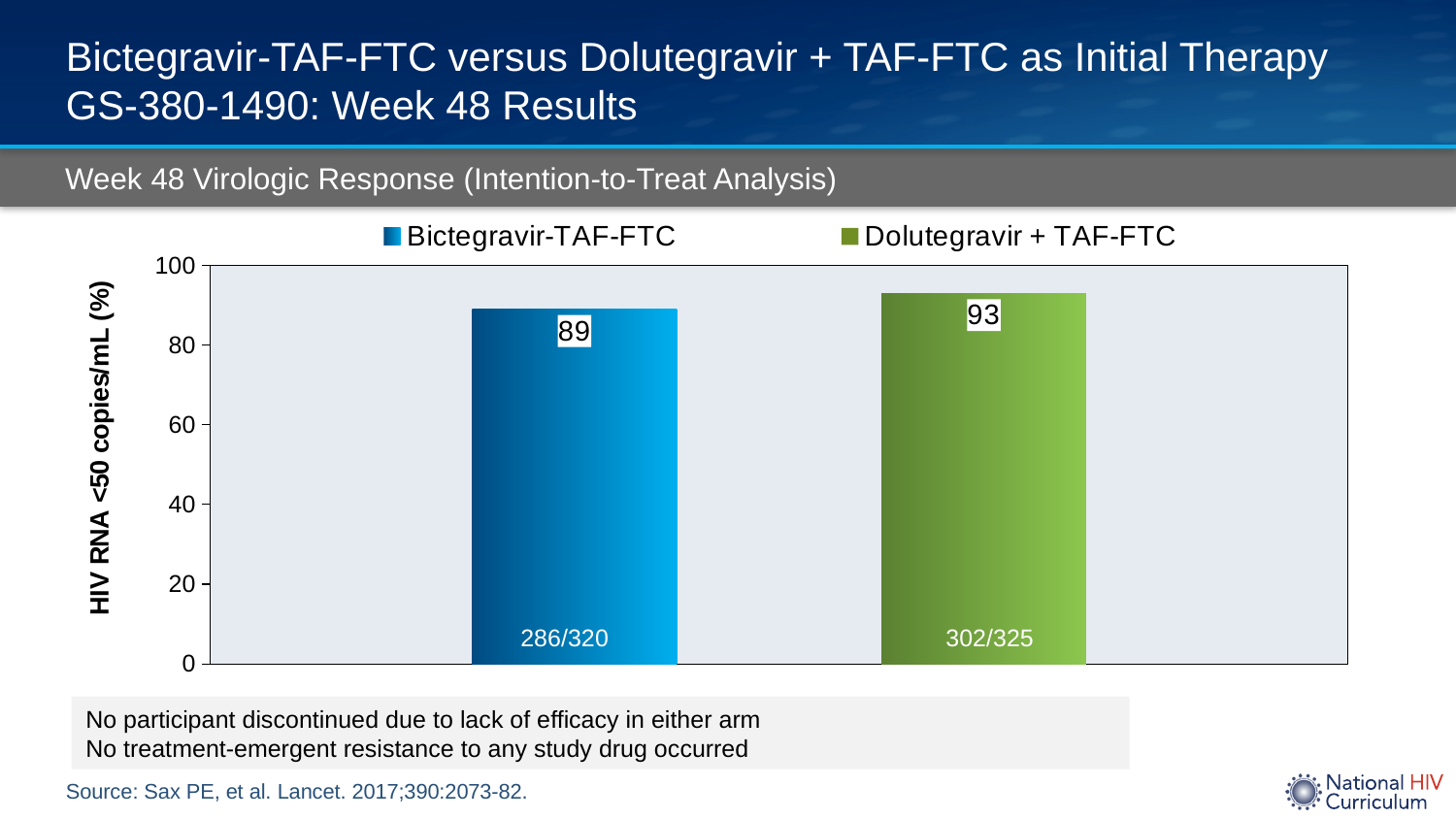
What is the value for Dolutegravir + TAF-FTC? 93 Is the value for Bictegravir-TAF-FTC greater or less than 80? greater What is the value for Bictegravir-TAF-FTC? 89 Is the value for Bictegravir-TAF-FTC larger or smaller than the value for Dolutegravir + TAF-FTC? smaller What kind of chart is shown? bar chart Which treatment arm has the higher value? Dolutegravir + TAF-FTC What fraction is printed at the base of the Bictegravir-TAF-FTC bar? 286/320 What is the difference between the values for Dolutegravir + TAF-FTC and Bictegravir-TAF-FTC? 4 What is the label of the y axis? HIV RNA <50 copies/mL (%) How many series does the legend list? 2 How many bars are plotted in the chart? 2 Which treatment arm has the lower value? Bictegravir-TAF-FTC